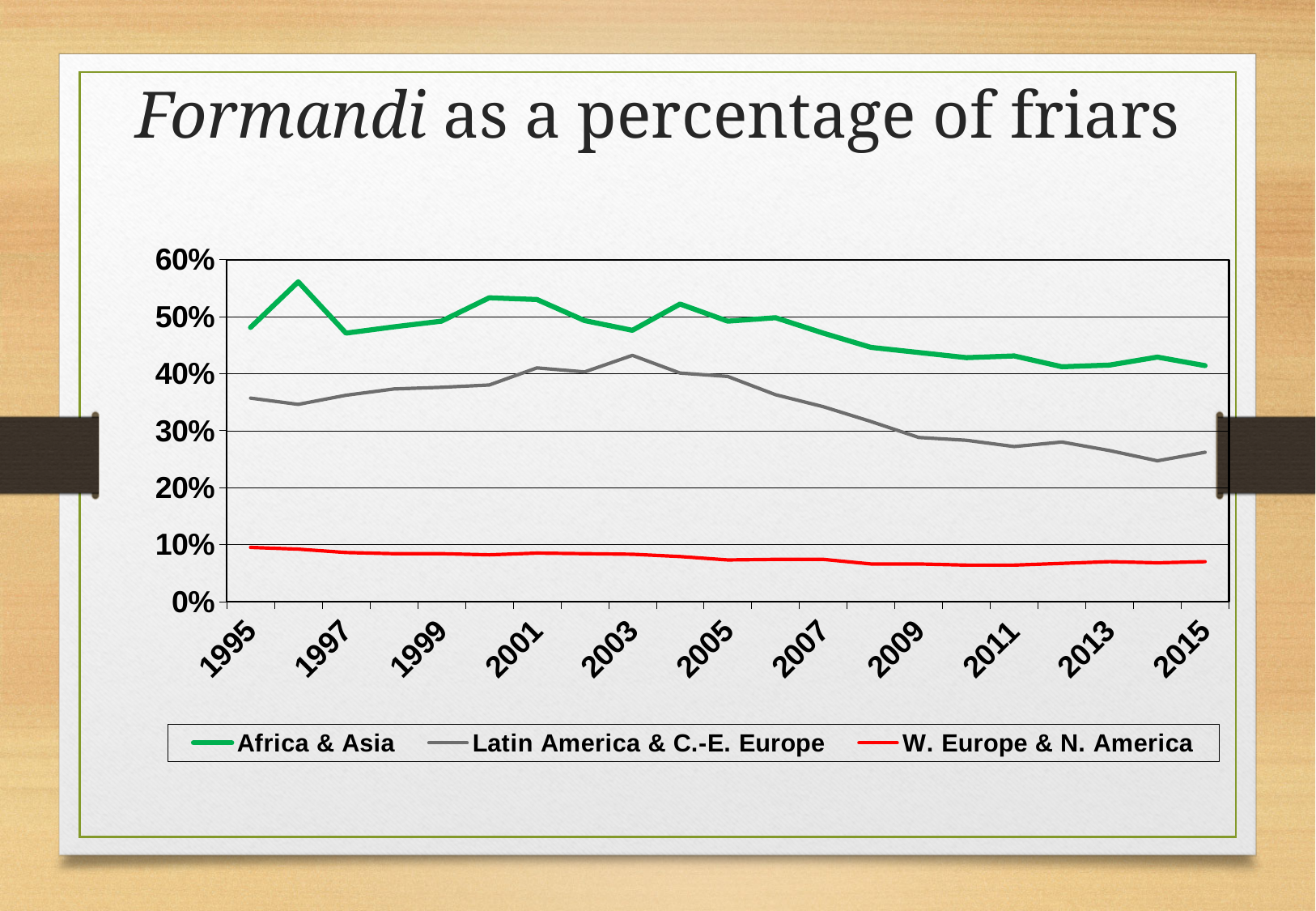
Which series has the highest values across the whole period? Africa & Asia Which series has the lowest values across the whole period? W. Europe & N. America Is the value for Africa & Asia in 2015 greater or less than 50%? less How many series does the legend list? 3 What kind of chart is shown on the slide? line chart Is the value for W. Europe & N. America in 2015 greater or less than 20%? less How many years are labelled on the x axis? 11 In 2005, which is larger: the value for Africa & Asia or the value for Latin America & C.-E. Europe? Africa & Asia Is the value for Latin America & C.-E. Europe in 2015 greater or less than 30%? less What colour is the line for W. Europe & N. America? red Does the Latin America & C.-E. Europe line rise or fall between 2003 and 2015? fall